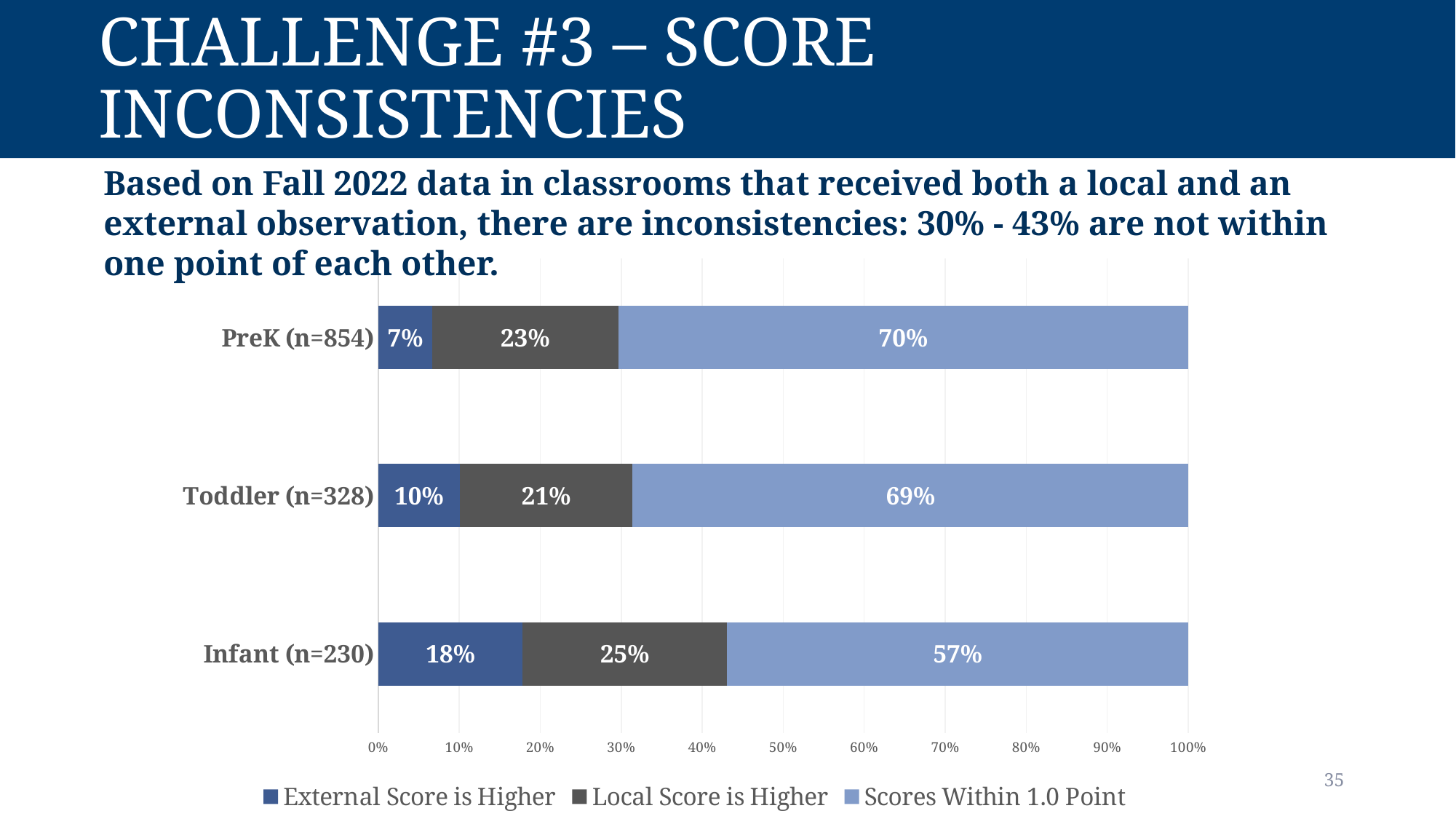
Which series is shown in the darkest grey colour in the legend? Local Score is Higher What is the value for 'Local Score is Higher' for Toddler (n=328)? 21% What is the value for 'External Score is Higher' for Infant (n=230)? 18% Which age group has the lowest percentage for 'Scores Within 1.0 Point'? Infant (n=230) What kind of chart is shown on the slide? Stacked bar chart What percentage of PreK classrooms had scores within 1.0 point? 70% Which is larger: 'Local Score is Higher' for Infant or for PreK? Infant How many age groups are shown in the chart? 3 What is the difference between the 'Scores Within 1.0 Point' values for PreK and Infant? 13% Which age group has the highest percentage for 'External Score is Higher'? Infant (n=230) How many series does the legend list? 3 What is the total of the 'External Score is Higher' and 'Local Score is Higher' segments for Toddler (n=328)? 31%